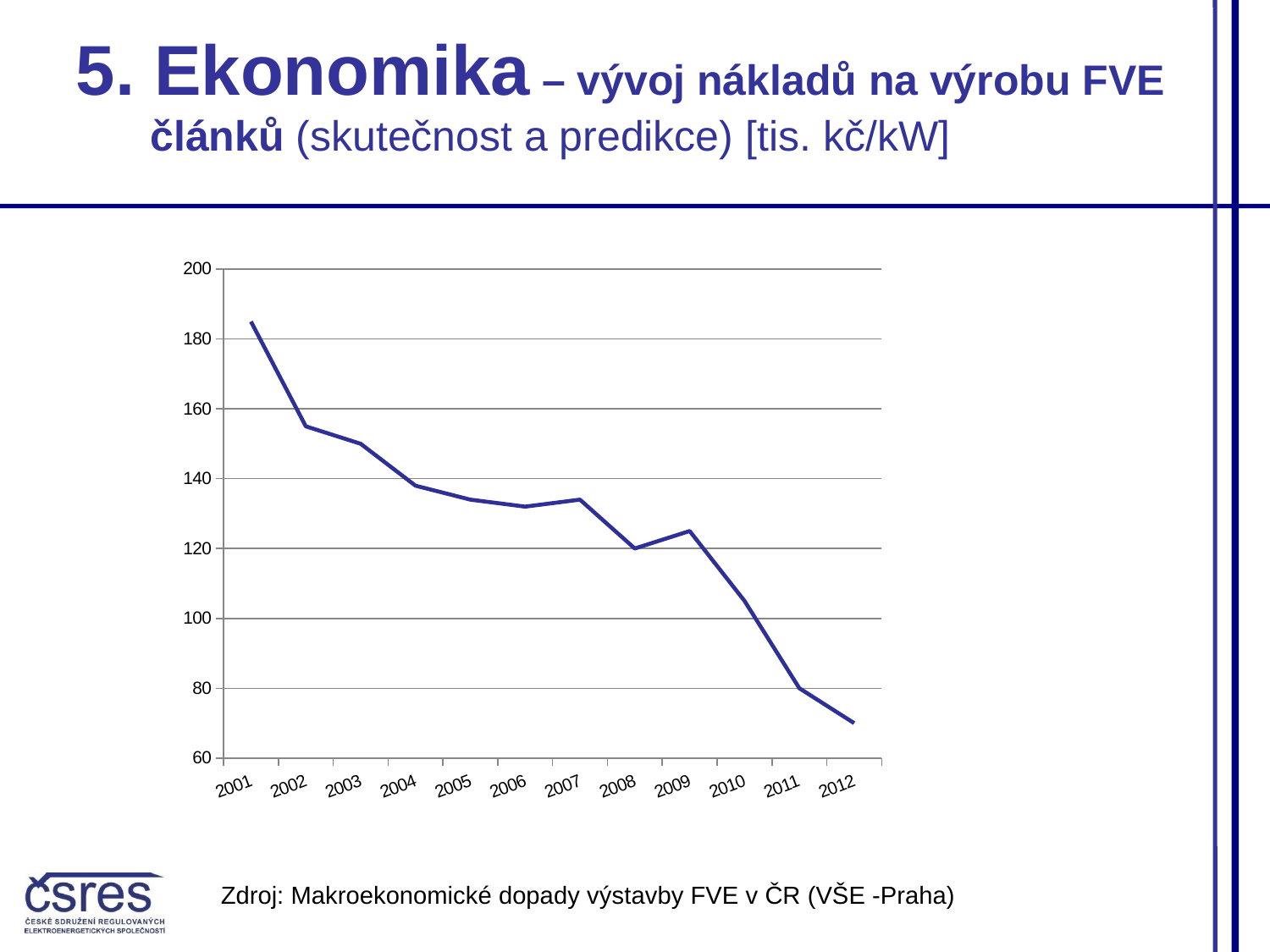
What kind of chart is shown on the slide? line chart Is the value for 2001 greater or less than 180? greater Is the value for 2010 greater or less than 100? greater Which year has the larger value, 2003 or 2009? 2003 Which year has the highest value on the chart? 2001 Which year has the lowest value on the chart? 2012 What unit is given in the slide title for the plotted values? tis. kč/kW Is the value for 2002 greater or less than 160? less How many years are plotted along the x axis of the chart? 12 Do the values generally rise or fall from 2001 to 2012? fall